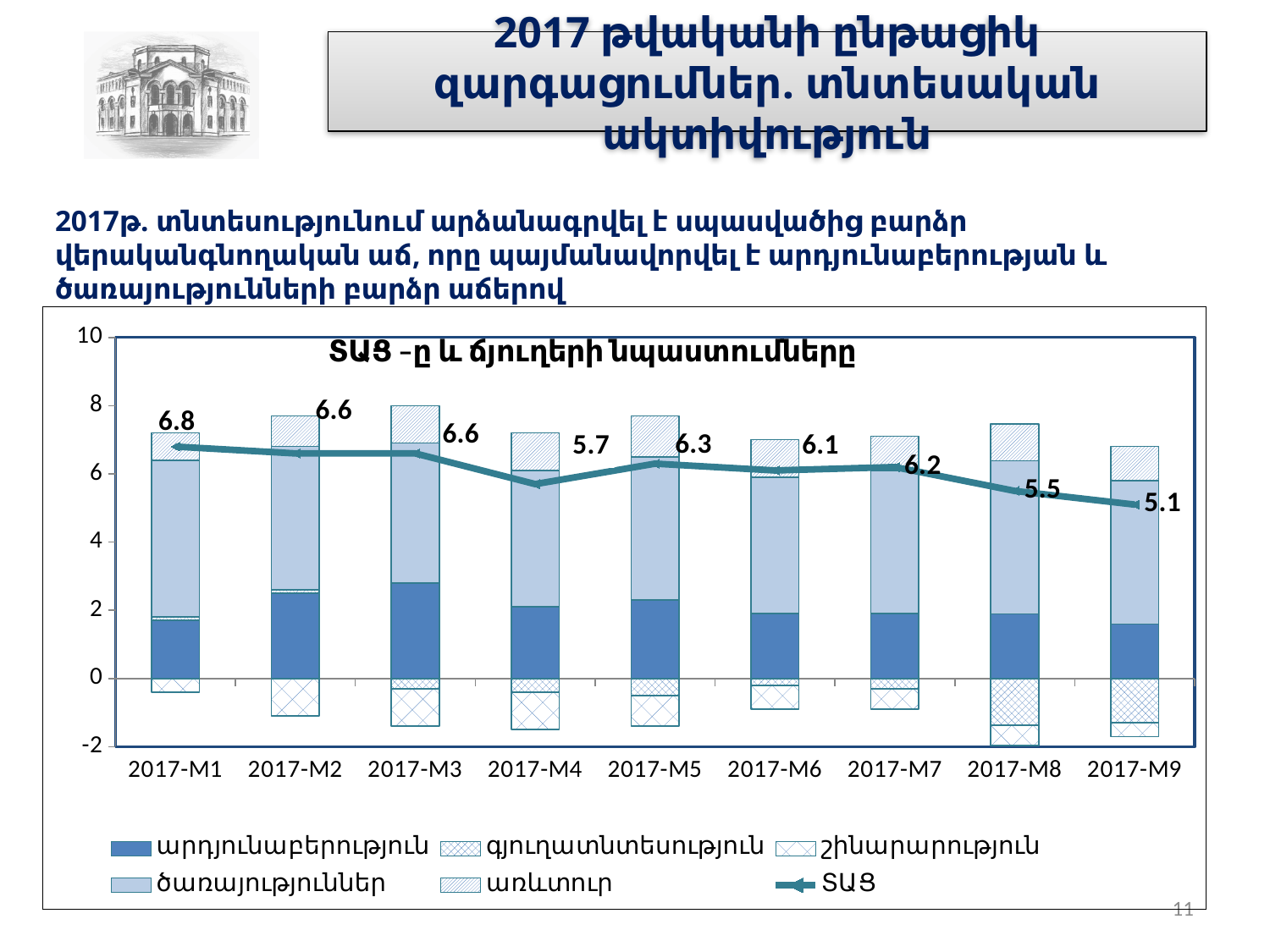
Is the արդյունաբերություն bar segment for 2017-M3 greater or less than 2? greater What is the ՏԱՑ value for 2017-M9? 5.1 How many series does the legend list? 6 What is the difference between the ՏԱՑ values for 2017-M1 and 2017-M9? 1.7 What is the ՏԱՑ value for 2017-M1? 6.8 Does the ՏԱՑ line generally rise or fall from 2017-M1 to 2017-M9? fall Which is larger, the ՏԱՑ value for 2017-M7 or for 2017-M8? 2017-M7 What is the ՏԱՑ value for 2017-M4? 5.7 In which month is the ՏԱՑ line at its lowest? 2017-M9 What is the difference between the ՏԱՑ values for 2017-M5 and 2017-M4? 0.6 How many months are shown on the x axis? 9 In which month is the ՏԱՑ line at its highest? 2017-M1